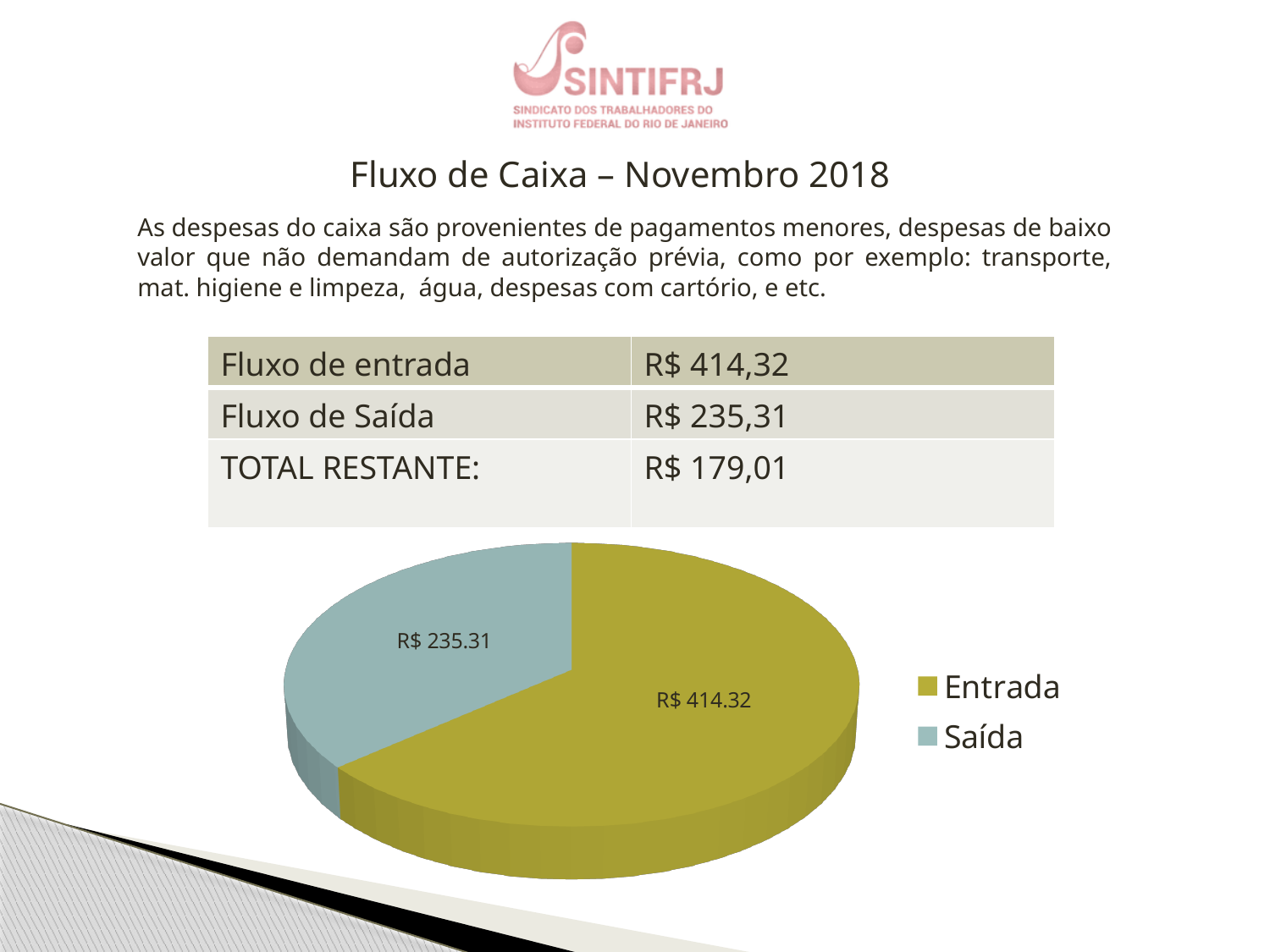
What is the total of the two slices in the pie chart? R$ 649.63 Which legend entry of the pie chart is shown in the olive/yellow-green colour? Entrada How many slices does the pie chart have? 2 What is the difference between the Entrada and Saída values in the pie chart? R$ 179.01 What is the value of the Entrada slice in the pie chart? R$ 414.32 What is the value of the Saída slice in the pie chart? R$ 235.31 What share of the pie does the Entrada slice represent? 63.8% Which slice of the pie chart is the largest? Entrada What kind of chart is shown on the slide? pie chart Which slice of the pie chart is the smallest? Saída How many entries does the pie chart's legend list? 2 Which is larger in the pie chart, Entrada or Saída? Entrada